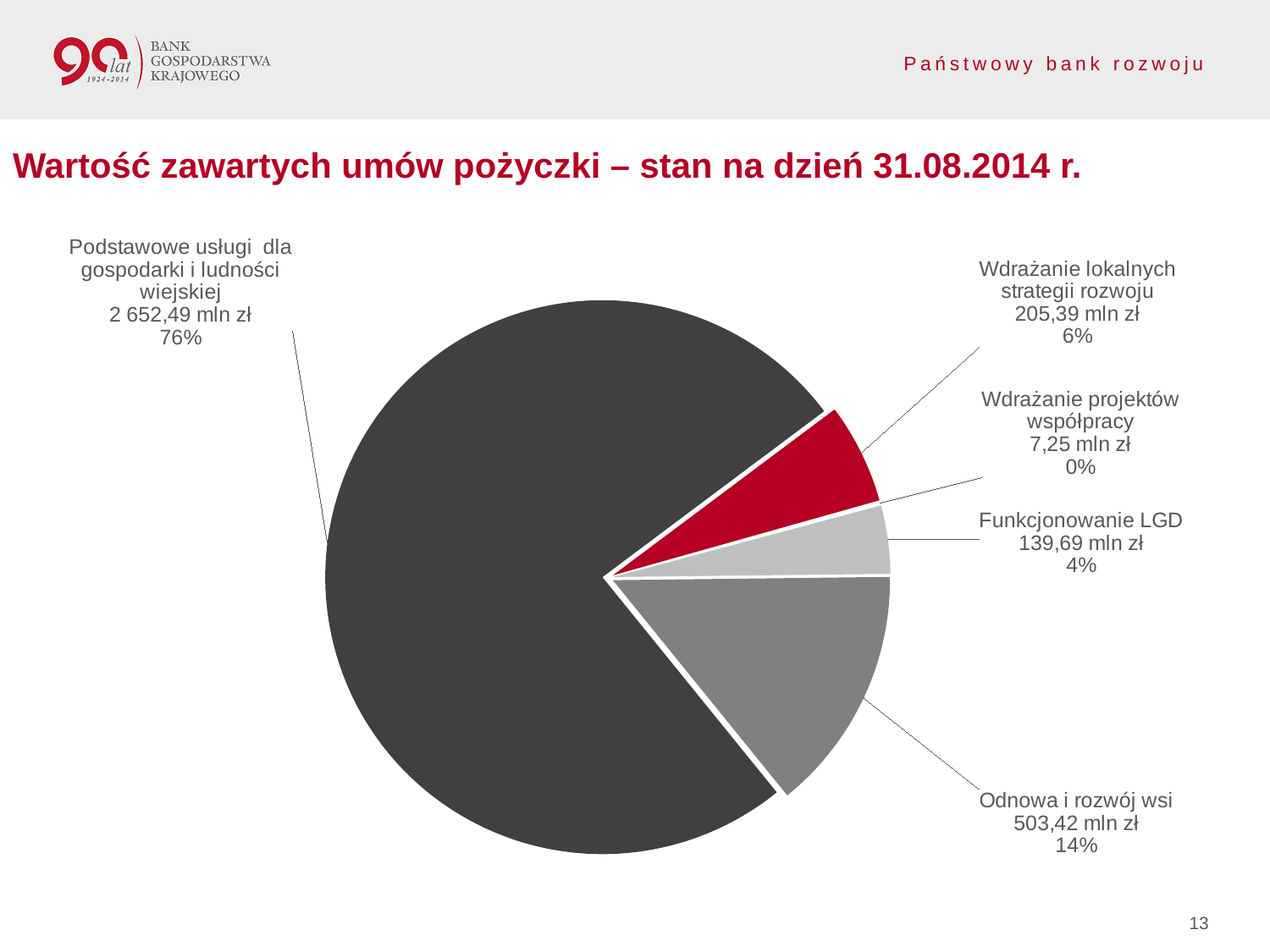
What share of the pie does "Wdrażanie projektów współpracy" represent? 0% What is the value for "Odnowa i rozwój wsi"? 503,42 mln zł Which category has the smallest slice of the pie? Wdrażanie projektów współpracy What share of the pie does "Odnowa i rozwój wsi" represent? 14% What kind of chart is shown on the slide? Pie chart Which category has the largest slice of the pie? Podstawowe usługi dla gospodarki i ludności wiejskiej What is the value for "Funkcjonowanie LGD"? 139,69 mln zł How many slices does the pie chart have? 5 What is the value for "Podstawowe usługi dla gospodarki i ludności wiejskiej"? 2 652,49 mln zł What is the value for "Wdrażanie lokalnych strategii rozwoju"? 205,39 mln zł What is the title of the chart on the slide? Wartość zawartych umów pożyczki – stan na dzień 31.08.2014 r. Which is larger: "Wdrażanie lokalnych strategii rozwoju" or "Funkcjonowanie LGD"? Wdrażanie lokalnych strategii rozwoju